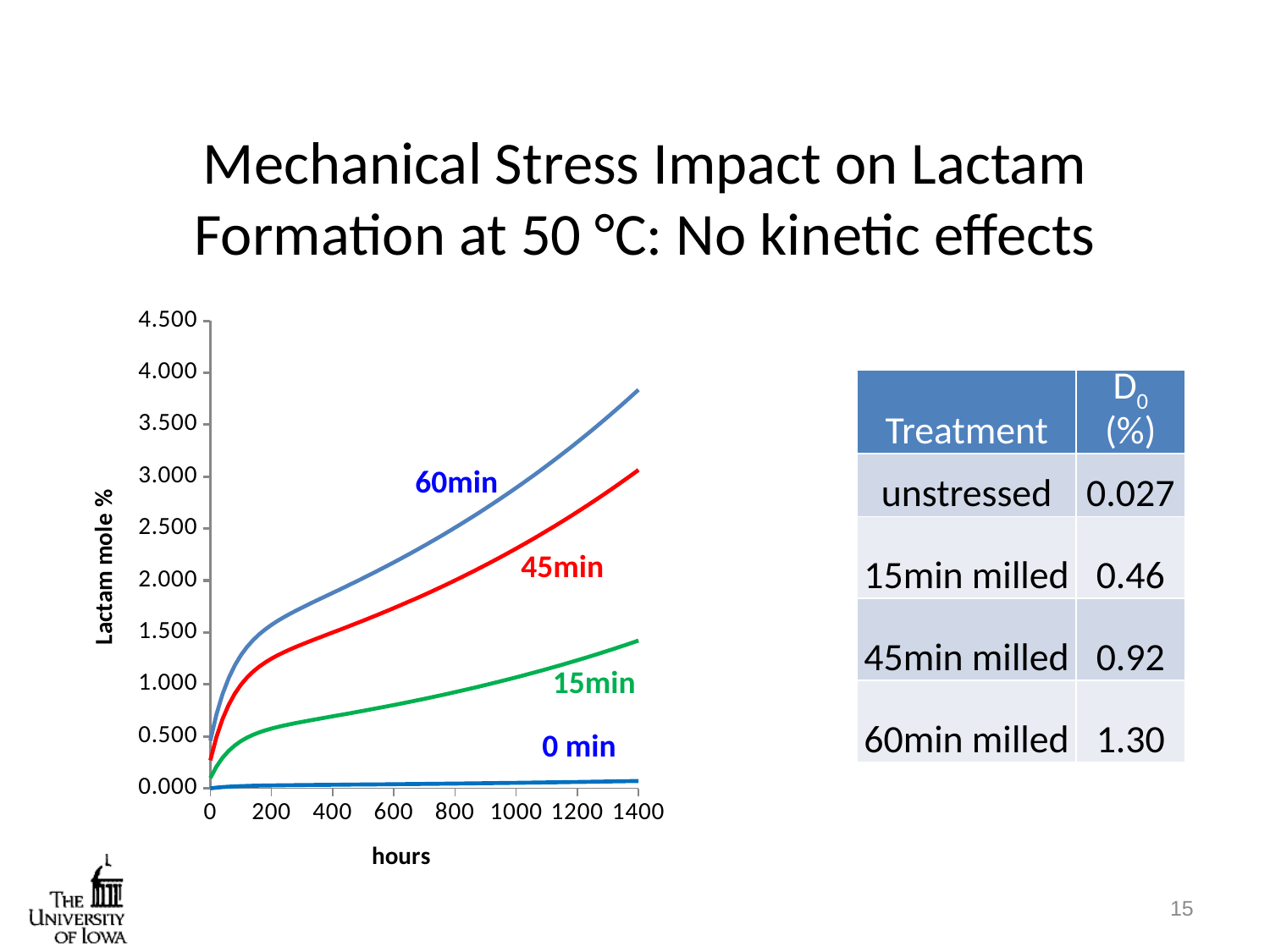
Is the value of the 60min series at 1400 hours greater or less than 3.500? greater What is the label of the x axis of the chart? hours Is the value of the 15min series at 1400 hours greater or less than 1.000? greater Do the values of the 45min series rise or fall as hours increase? rise At 1000 hours, which series has the larger value, 60min or 45min? 60min What kind of chart is shown on the slide? line chart Is the value of the 0 min series at 1400 hours greater or less than 0.500? less Which series has the highest lactam mole % at 1400 hours? 60min Which series has the lowest lactam mole % across the chart? 0 min What is the label of the y axis of the chart? Lactam mole % How many lines (series) are plotted on the chart? 4